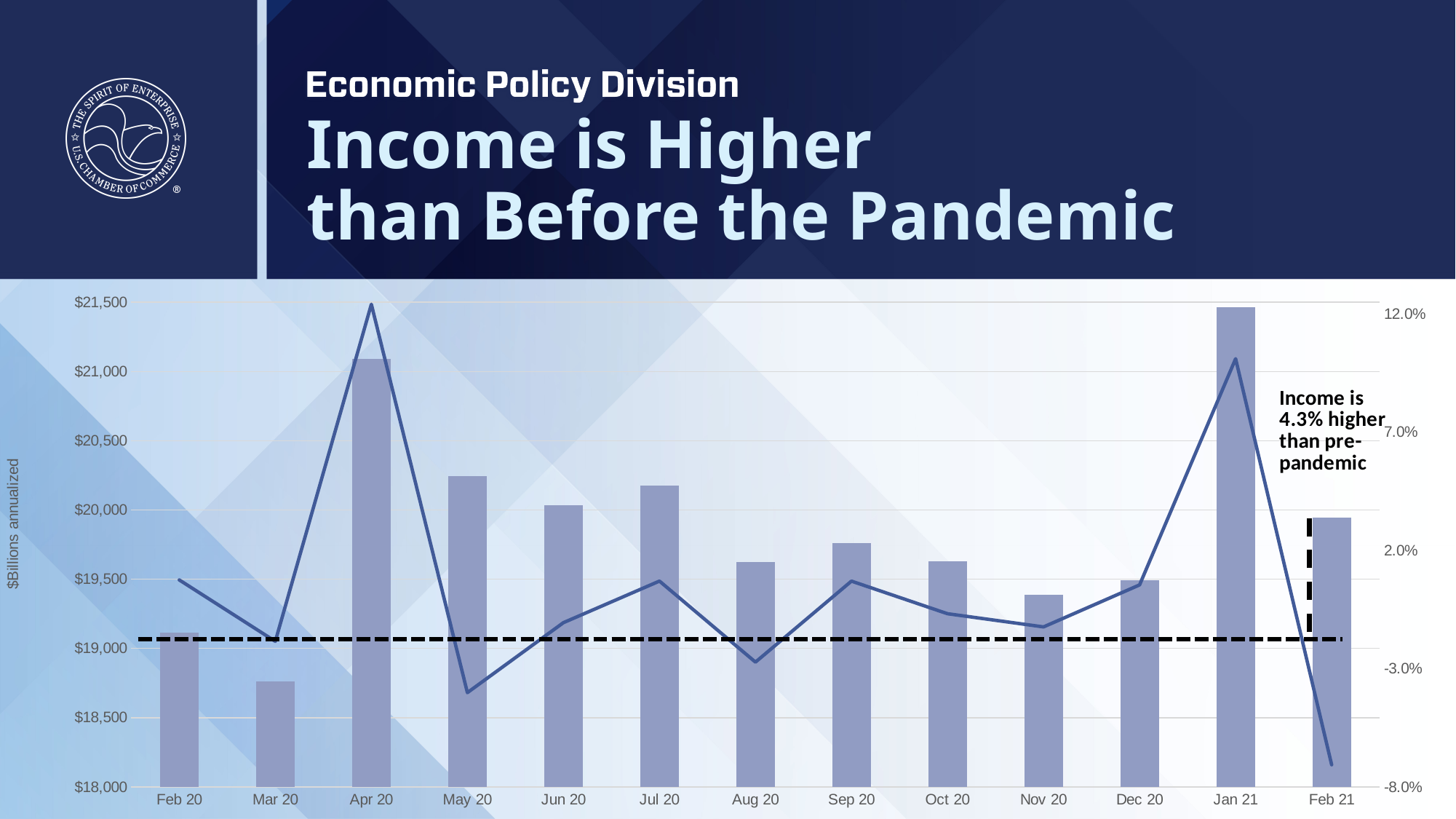
At which month does the line reach its lowest point? Feb 21 Is the line value for Feb 21 greater or less than -3.0% on the right axis? less What kind of chart is shown on the slide? A combination bar and line chart According to the annotation on the chart, how much higher is income than pre-pandemic? 4.3% Is the bar value for May 20 greater or less than $20,000? greater Which month has the tallest bar? Jan 21 How many months are shown on the x axis of the chart? 13 Which bar is taller, Apr 20 or May 20? Apr 20 Is the bar value for Mar 20 greater or less than $19,000? less Which month has the shortest bar? Mar 20